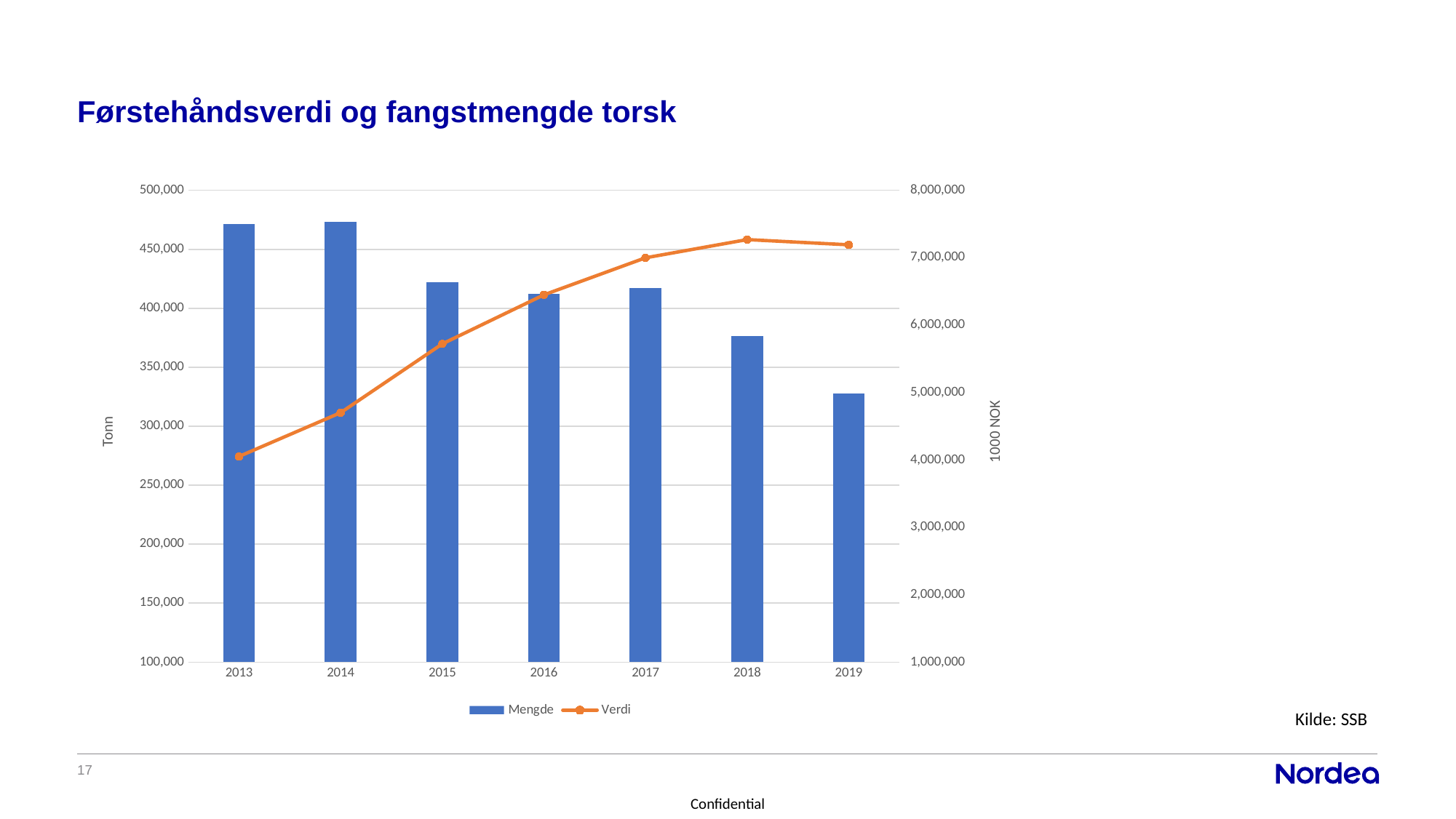
Is the Mengde value for 2015 greater or less than 400,000? greater Does the Verdi line generally rise or fall from 2013 to 2018? rise Is the Mengde value for 2019 greater or less than 350,000? less What is the label on the right-hand vertical axis? 1000 NOK How many years are shown on the x axis? 7 Which year has the lowest Verdi (line) value? 2013 What type of chart is shown on the slide? A combined bar and line chart Which is larger, the Mengde value for 2015 or for 2018? 2015 Which year has the lowest Mengde (bar) value? 2019 Is the Verdi value for 2018 greater or less than 7,000,000? greater How many series does the legend list? 2